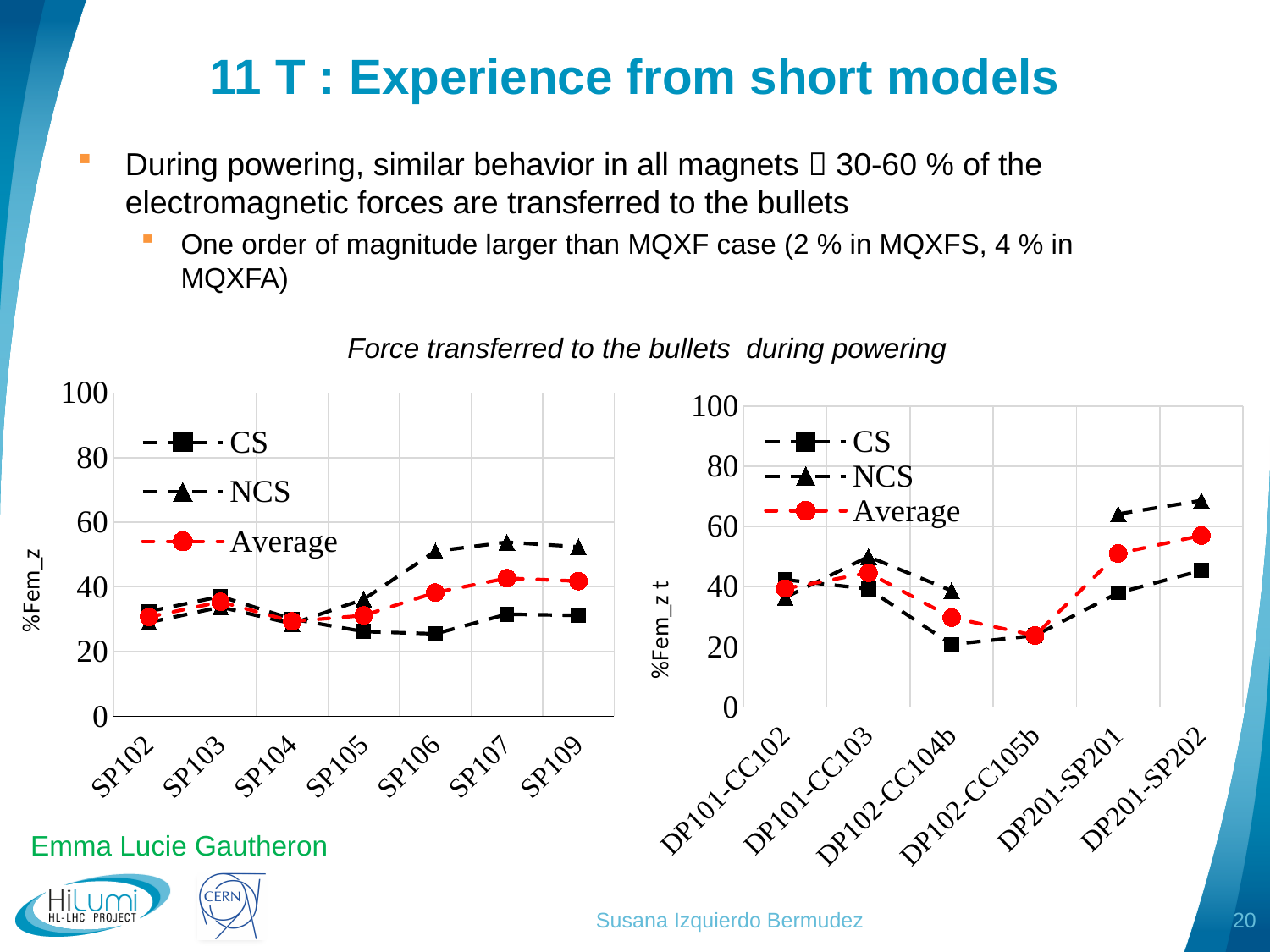
In the right chart (DP101-CC102 to DP201-SP202), is the CS value for DP102-CC104b greater or less than 40? less In the right chart (DP101-CC102 to DP201-SP202), which is larger at DP201-SP201, the CS value or the NCS value? NCS In the right chart (DP101-CC102 to DP201-SP202), which category has the highest Average value? DP201-SP202 In the left chart (SP102 to SP109), is the NCS value for SP107 greater or less than 40? greater What colour is the Average series drawn in on both charts? red How many categories are shown on the x axis of the left chart (SP102 to SP109)? 7 How many series does the legend of the right chart (DP101-CC102 to DP201-SP202) list? 3 How many categories are shown on the x axis of the right chart (DP101-CC102 to DP201-SP202)? 6 In the left chart (SP102 to SP109), which is larger at SP106, the CS value or the NCS value? NCS What kind of chart is the left chart (SP102 to SP109)? line chart In the left chart (SP102 to SP109), is the CS value for SP106 greater or less than 40? less